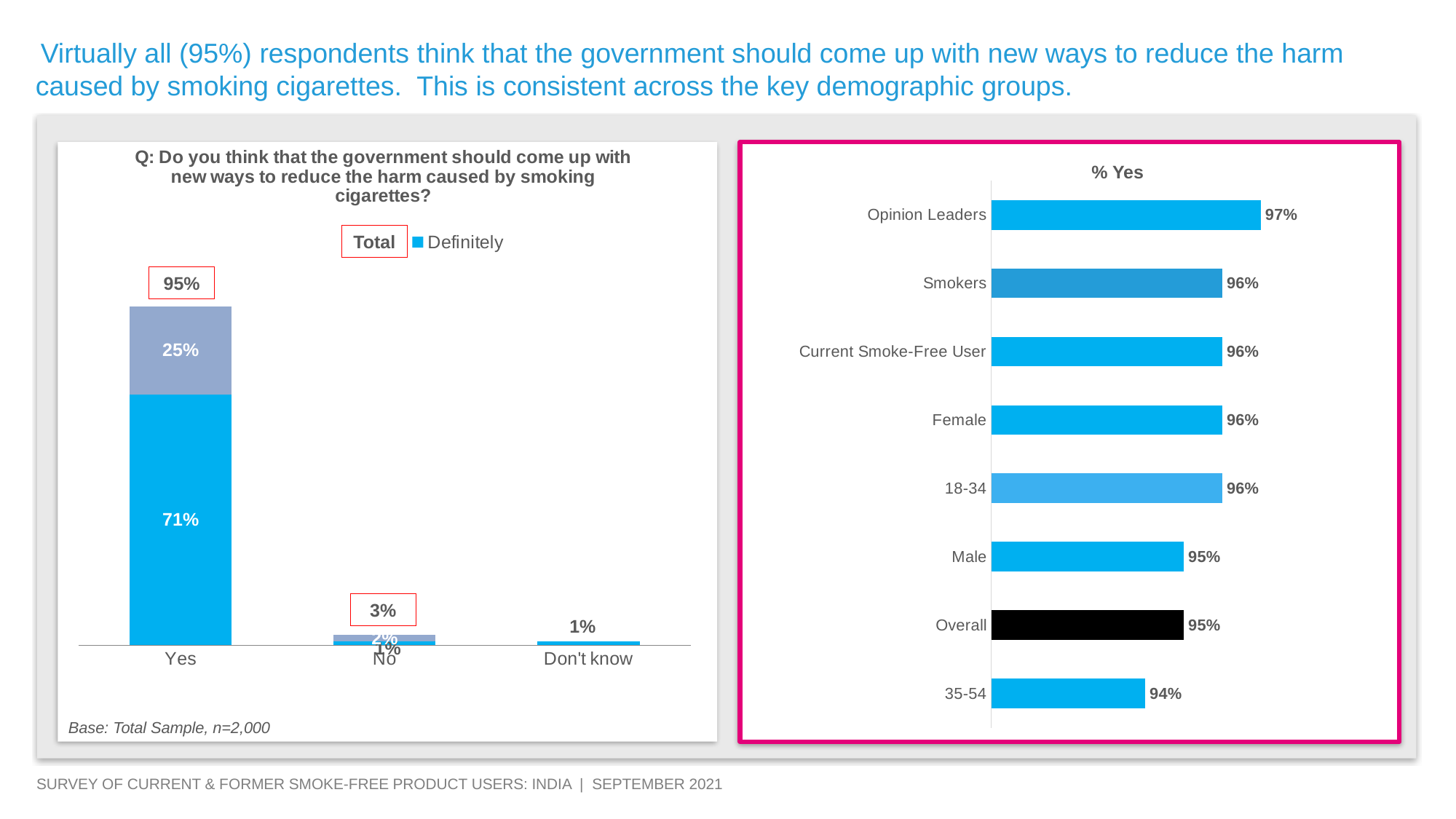
In the chart on the left, what is the total for the No bar? 3% In the '% Yes' chart on the right, how many categories are shown? 8 In the '% Yes' chart on the right, what is the value for Opinion Leaders? 97% In the '% Yes' chart on the right, what is the value for the 35-54 age group? 94% What kind of chart is the '% Yes' chart on the right? Bar chart In the '% Yes' chart on the right, what is the value for Overall? 95% In the chart on the left, what is the value for Don't know? 1% In the chart on the left, what is the total for the Yes bar? 95% In the '% Yes' chart on the right, which category has the lowest value? 35-54 In the '% Yes' chart on the right, which category has the highest value? Opinion Leaders In the '% Yes' chart on the right, what is the difference between Opinion Leaders and 35-54? 3% In the chart on the left, what is the 'Definitely' value for the Yes category? 71%